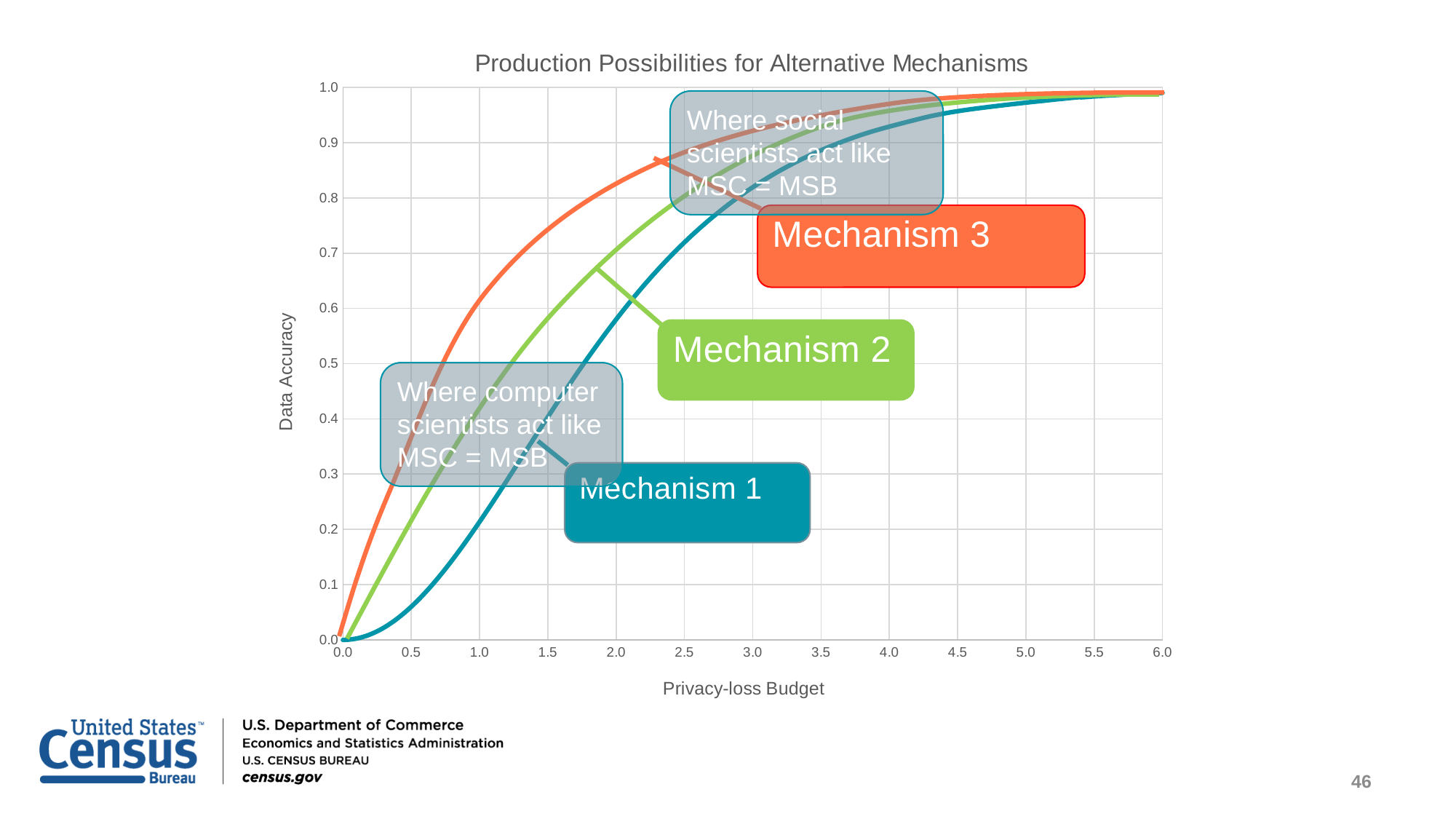
What is the label of the y axis? Data Accuracy What is the maximum value shown on the Privacy-loss Budget axis? 6.0 What is the title of the chart? Production Possibilities for Alternative Mechanisms At a Privacy-loss Budget of 1.0, is the Data Accuracy for Mechanism 1 greater or less than 0.5? less What kind of chart is shown on the slide? line chart Which mechanism has the lowest Data Accuracy at a Privacy-loss Budget of 1.0? Mechanism 1 At a Privacy-loss Budget of 1.0, is the Data Accuracy for Mechanism 3 greater or less than 0.5? greater At a Privacy-loss Budget of 1.5, which has higher Data Accuracy, Mechanism 2 or Mechanism 1? Mechanism 2 Does Data Accuracy rise or fall as the Privacy-loss Budget increases for Mechanism 1? rise At a Privacy-loss Budget of 2.0, is the Data Accuracy for Mechanism 1 greater or less than 0.5? greater Which mechanism has the highest Data Accuracy at a Privacy-loss Budget of 1.0? Mechanism 3 How many mechanism curves are plotted on the chart? 3